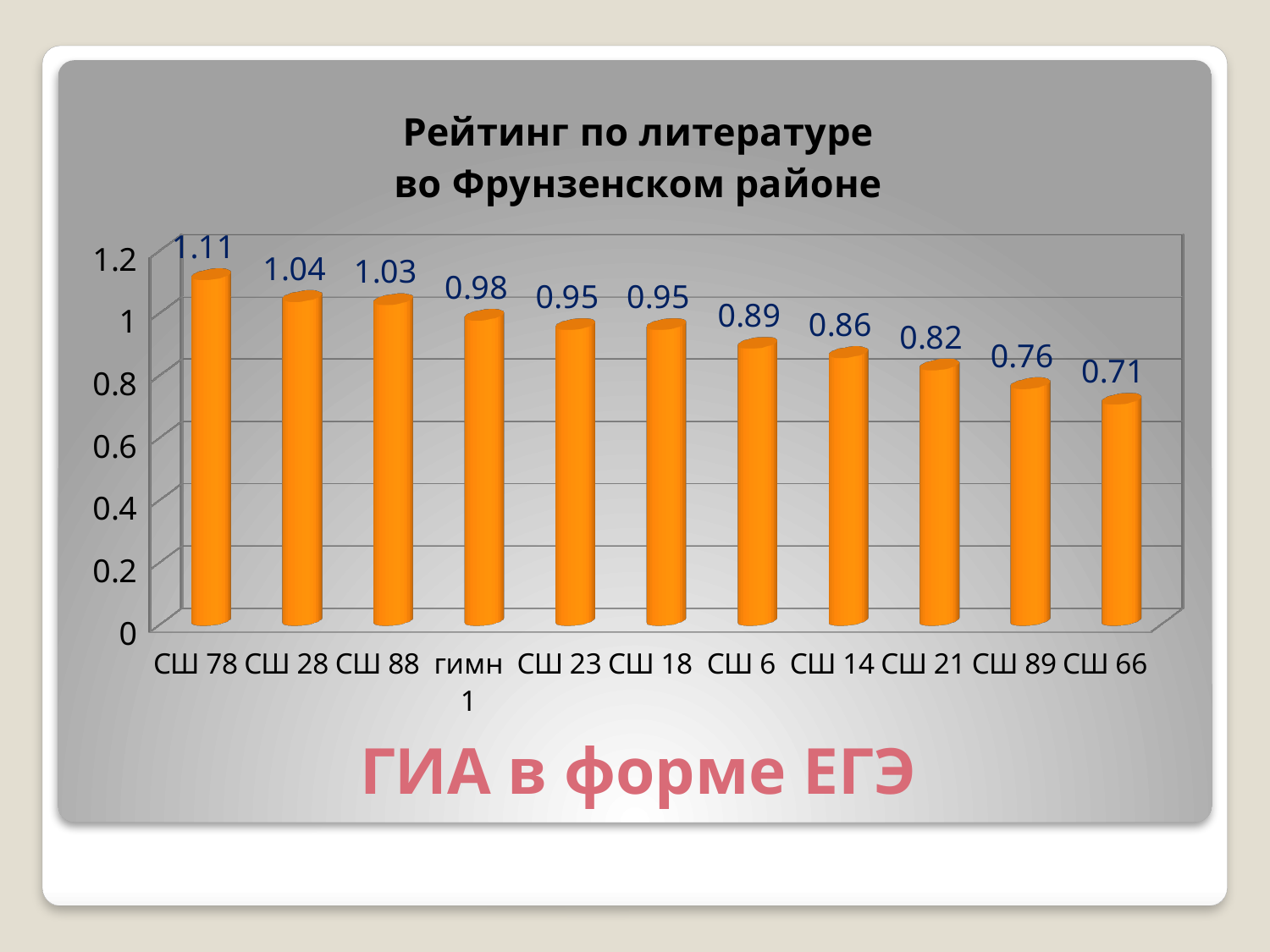
Which is larger, the value for СШ 88 or the value for СШ 14? СШ 88 What is the value for гимн 1? 0.98 What is the difference between the values for СШ 28 and СШ 6? 0.15 Which category has the highest value? СШ 78 Is the value for СШ 89 greater or less than 0.8? less What kind of chart is this? bar chart Do the values rise or fall from left to right along the x axis? fall How many categories are shown on the chart? 11 What is the value for СШ 21? 0.82 Which category has the lowest value? СШ 66 What is the value for СШ 78? 1.11 What is the difference between the values for СШ 78 and СШ 66? 0.4